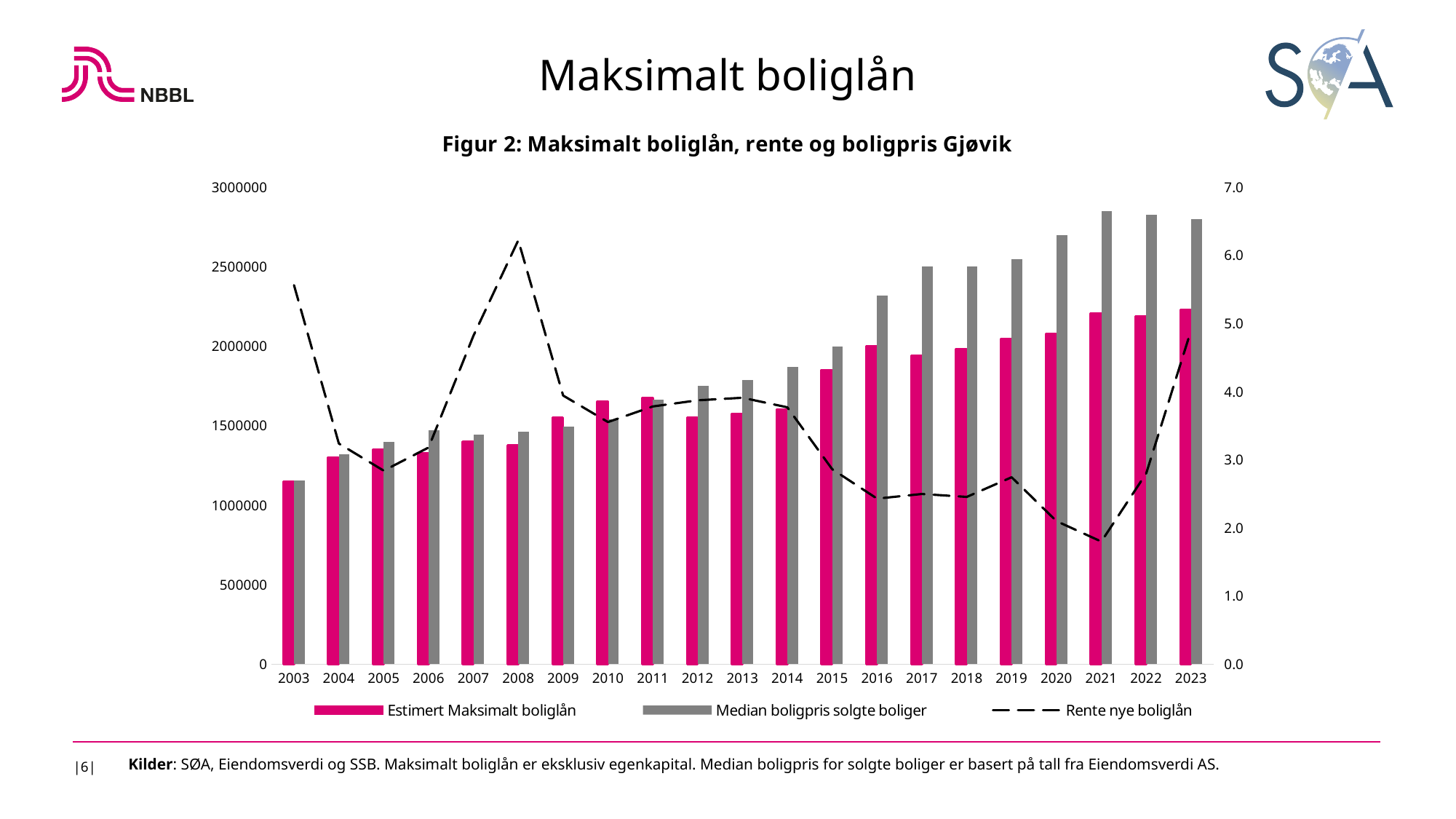
Is the value for Estimert Maksimalt boliglån in 2003 greater or less than 1000000? greater Is the value for Rente nye boliglån in 2003 greater or less than 5.0? greater In which year is Rente nye boliglån highest? 2008 What is the title of the chart on the slide? Figur 2: Maksimalt boliglån, rente og boligpris Gjøvik How many series does the legend of Figur 2 list? 3 In 2016, which is larger: Estimert Maksimalt boliglån or Median boligpris solgte boliger? Median boligpris solgte boliger Which series in Figur 2 is drawn as a dashed line? Rente nye boliglån Is the value for Median boligpris solgte boliger in 2021 greater or less than 2500000? greater In which year is Median boligpris solgte boliger lowest? 2003 How many years are shown on the x axis of Figur 2? 21 What kind of chart is shown in Figur 2? A combined bar and line chart